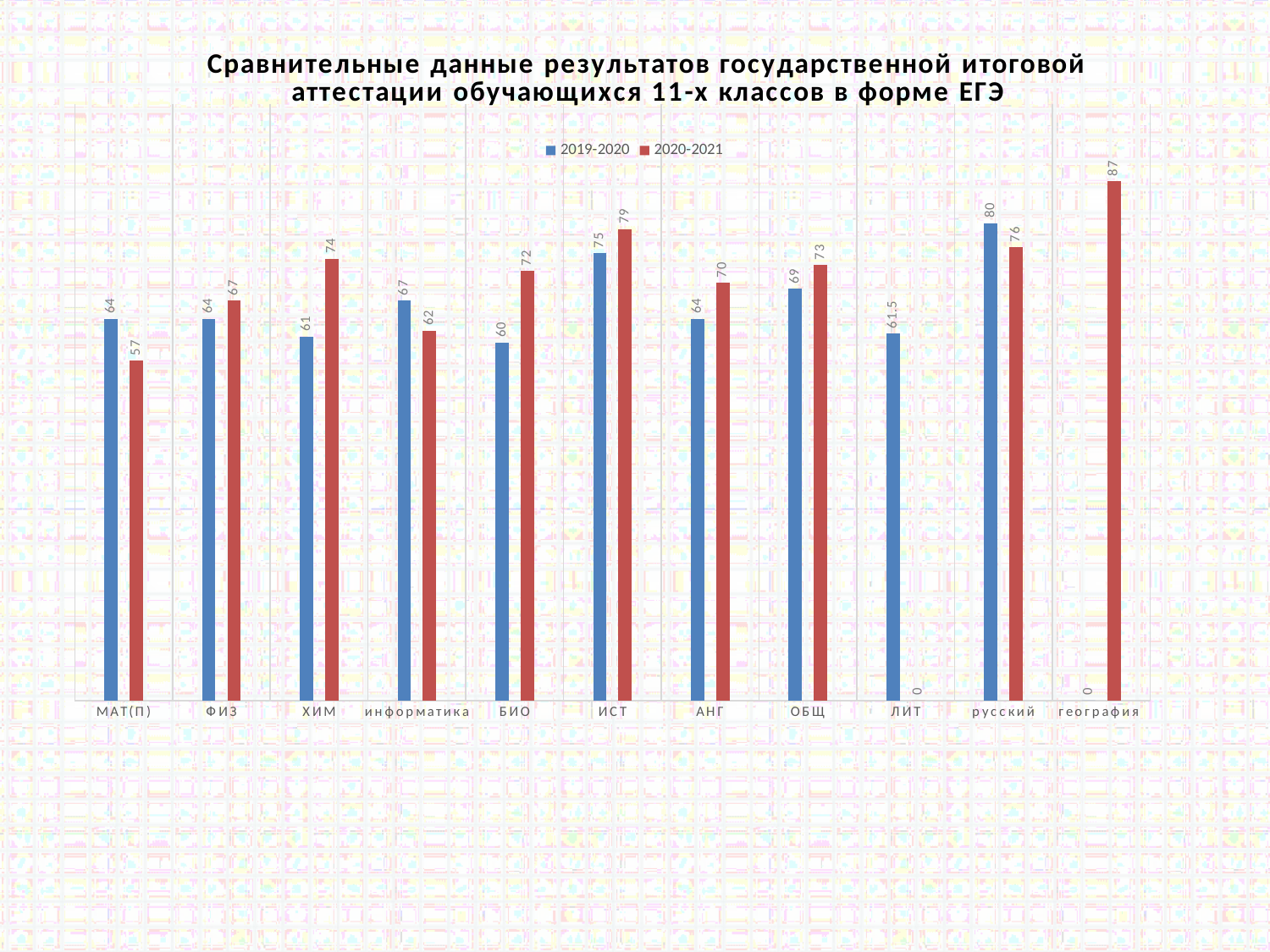
How many categories are shown on the x axis? 11 Which is larger for информатика: the 2019-2020 value or the 2020-2021 value? 2019-2020 What kind of chart is shown on the slide? Bar chart How many series does the legend list? 2 Which category has the highest 2020-2021 value? география Which category has the highest 2019-2020 value? русский Which category has the lowest non-zero 2020-2021 value? МАТ(П) What is the 2020-2021 value for МАТ(П)? 57 What is the 2019-2020 value for ЛИТ? 61.5 What is the 2020-2021 value for ХИМ? 74 What is the difference between the 2020-2021 and 2019-2020 values for БИО? 12 Which series is shown in red in the legend? 2020-2021